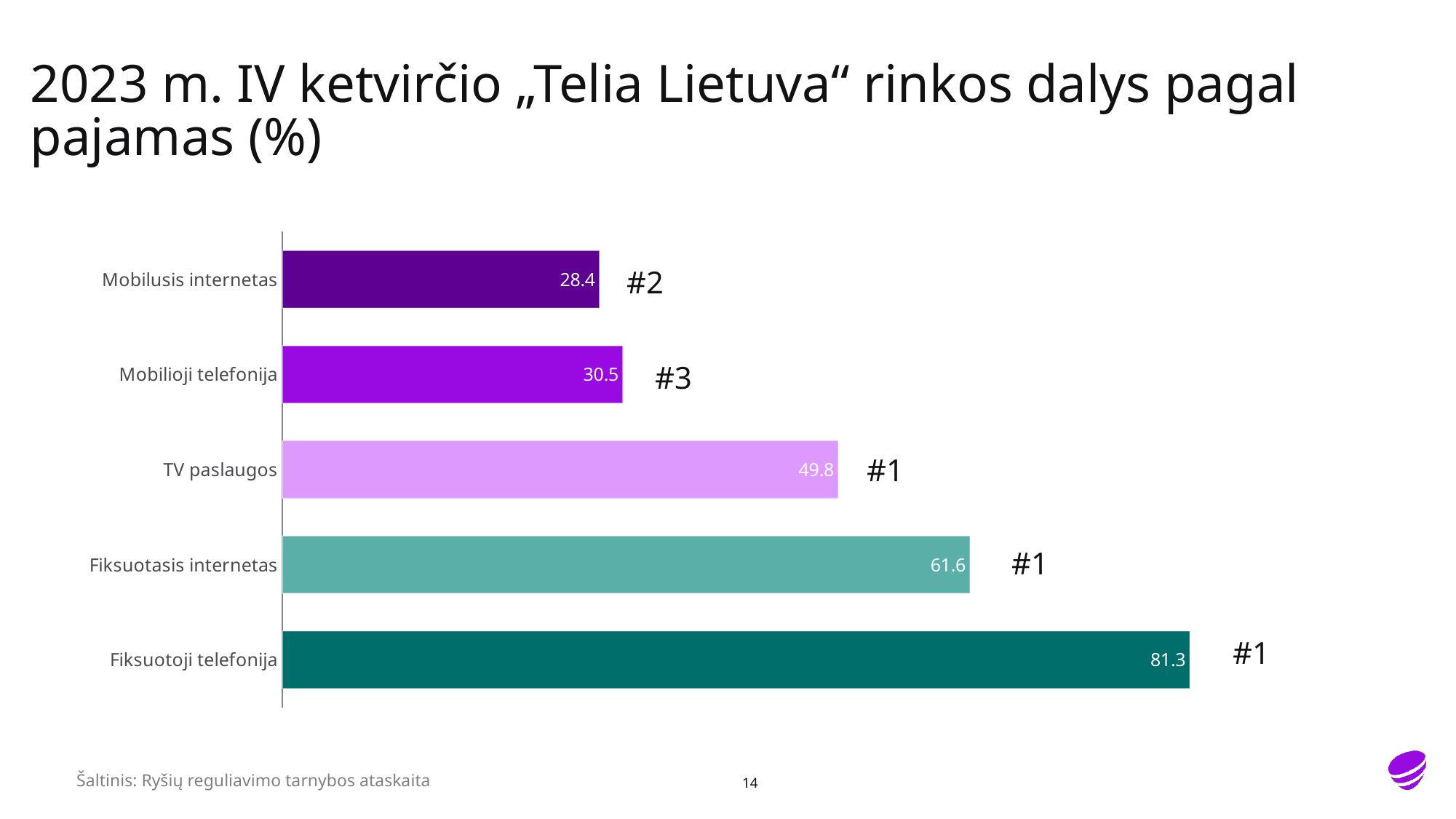
What is the value for Fiksuotasis internetas? 61.6 What kind of chart is shown on the slide? Bar chart What is the value for Fiksuotoji telefonija? 81.3 Which category has the highest value? Fiksuotoji telefonija What is the value for Mobilusis internetas? 28.4 Which is larger, the value for TV paslaugos or the value for Mobilioji telefonija? TV paslaugos What is the difference between the values for Mobilioji telefonija and Mobilusis internetas? 2.1 How many categories are shown in the chart? 5 Which category has the lowest value? Mobilusis internetas What is the value for TV paslaugos? 49.8 What market rank is shown next to the Mobilioji telefonija bar? #3 What is the difference between the values for Fiksuotoji telefonija and Fiksuotasis internetas? 19.7